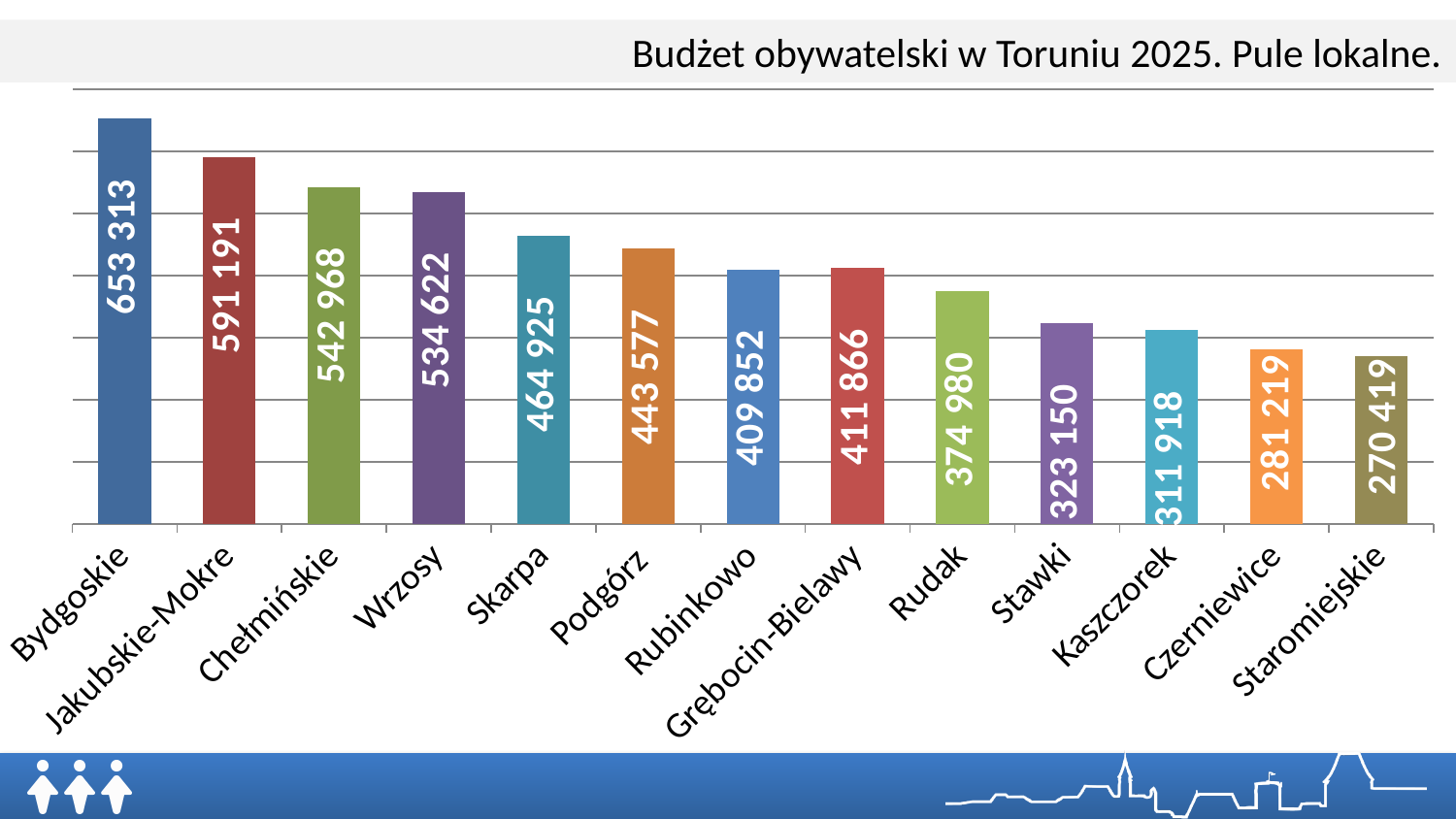
What is the value for Skarpa? 464 925 What kind of chart is shown on the slide? Bar chart How many categories are shown in the chart? 13 What is the value for Grębocin-Bielawy? 411 866 Which category has the highest value? Bydgoskie What is the value for Bydgoskie? 653 313 Which category has the lowest value? Staromiejskie What is the value for Kaszczorek? 311 918 What is the difference between the values for Bydgoskie and Staromiejskie? 382 894 What is the difference between the values for Chełmińskie and Wrzosy? 8 346 Which has a larger value, Podgórz or Rudak? Podgórz What is the title of the chart? Budżet obywatelski w Toruniu 2025. Pule lokalne.